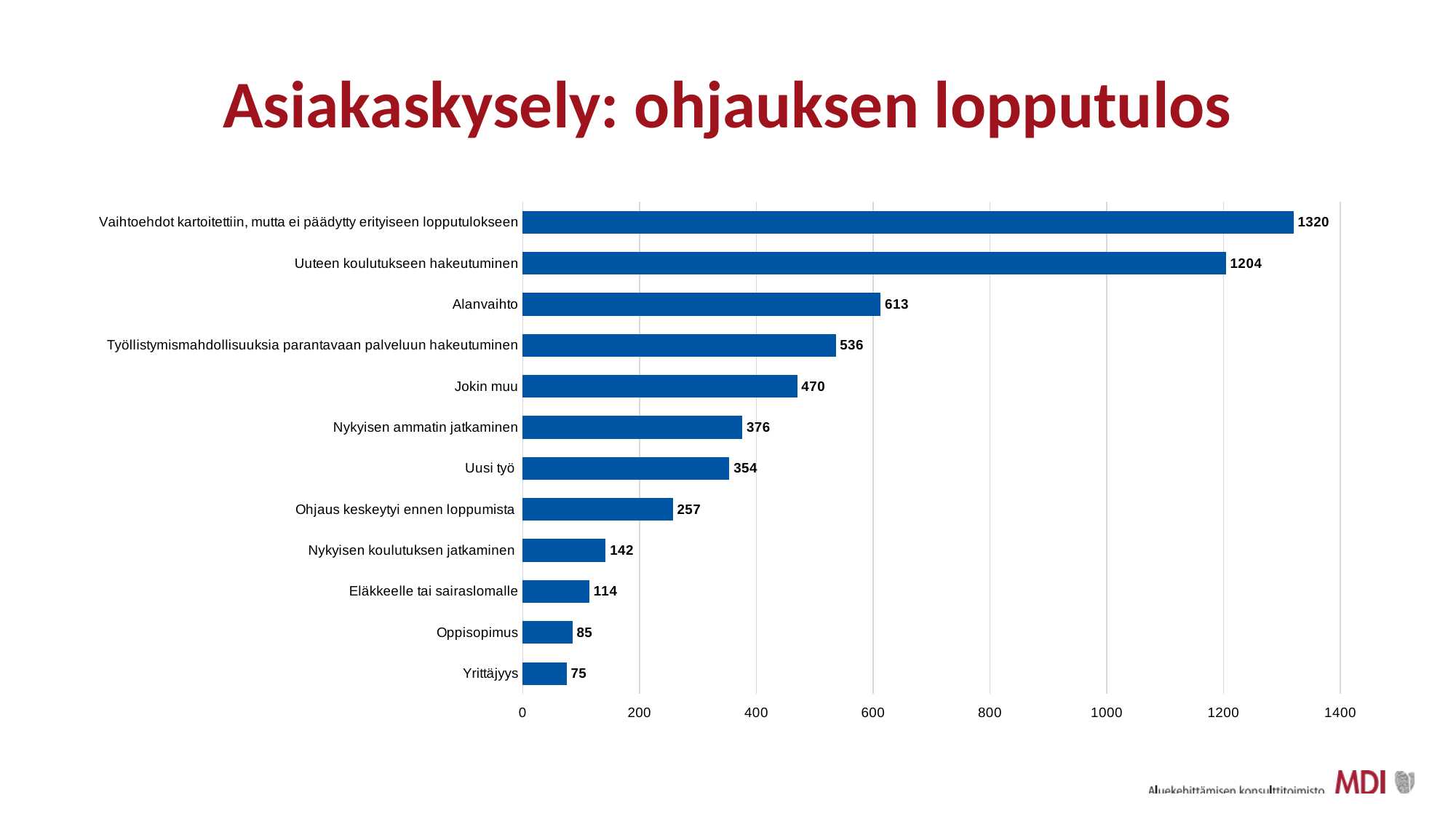
Is the value for Ohjaus keskeytyi ennen loppumista greater or less than 200? greater Which category has the lowest value? Yrittäjyys What is the title of the slide? Asiakaskysely: ohjauksen lopputulos What is the value for Alanvaihto? 613 What is the value for Oppisopimus? 85 What kind of chart is shown on the slide? Bar chart What is the difference between the values for Eläkkeelle tai sairaslomalle and Yrittäjyys? 39 What is the difference between the values for Uuteen koulutukseen hakeutuminen and Alanvaihto? 591 Which is larger: the value for Jokin muu or the value for Nykyisen ammatin jatkaminen? Jokin muu Which category has the highest value? Vaihtoehdot kartoitettiin, mutta ei päädytty erityiseen lopputulokseen What is the value for Uusi työ? 354 How many categories are shown in the chart? 12